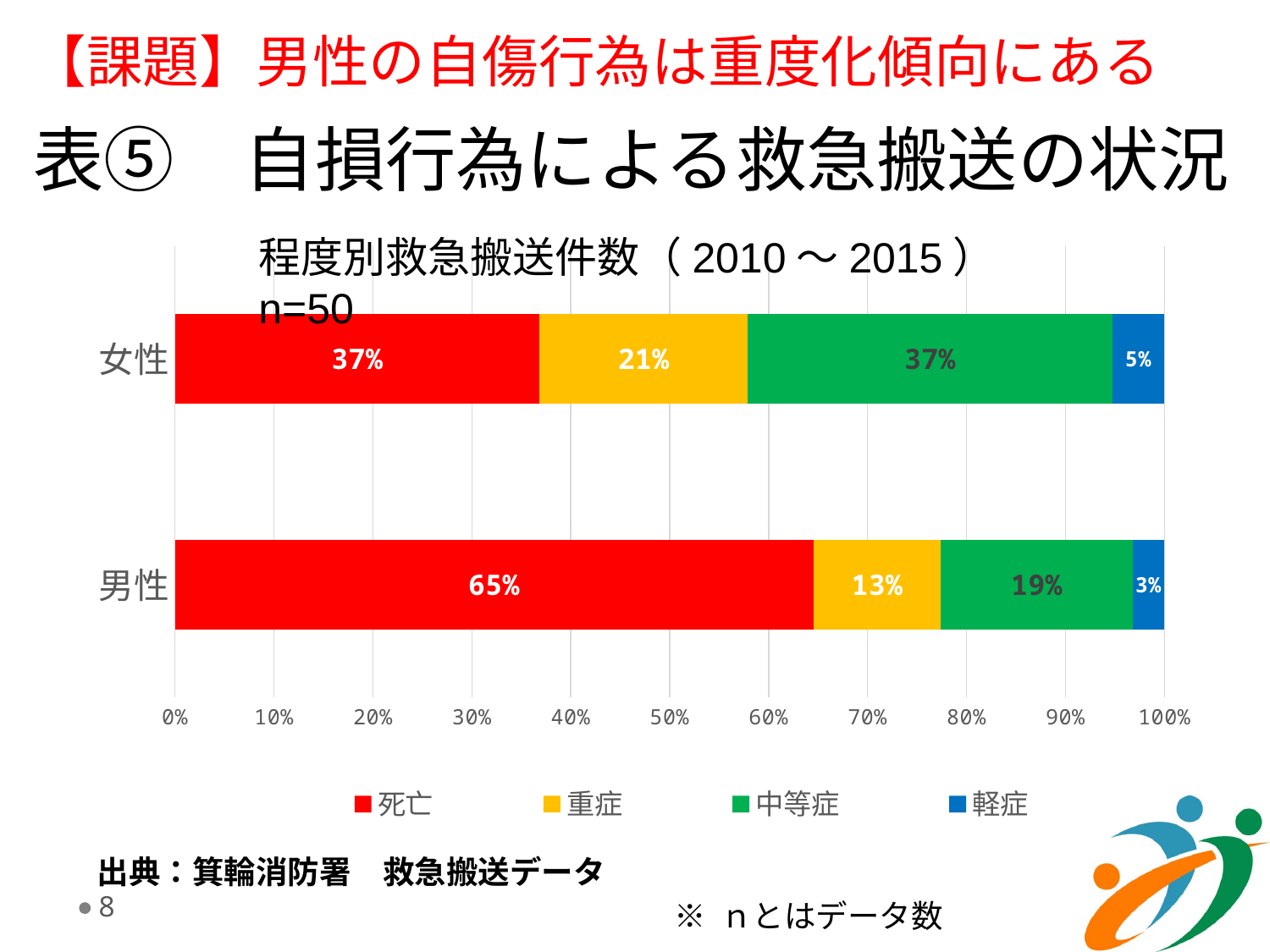
What is the 重症 value for 女性? 21% What is the 中等症 value for 男性? 19% Which series is shown in red in the legend? 死亡 What kind of chart is shown on the slide? stacked bar chart Which category has the higher 死亡 value, 女性 or 男性? 男性 Which category has the higher 中等症 value, 女性 or 男性? 女性 How many categories are plotted on the chart? 2 What is the difference between the 重症 values for 女性 and 男性? 8% What is the 死亡 value for 男性? 65% How many series does the legend list? 4 What is the difference between the 死亡 values for 男性 and 女性? 28% What is the 軽症 value for 女性? 5%